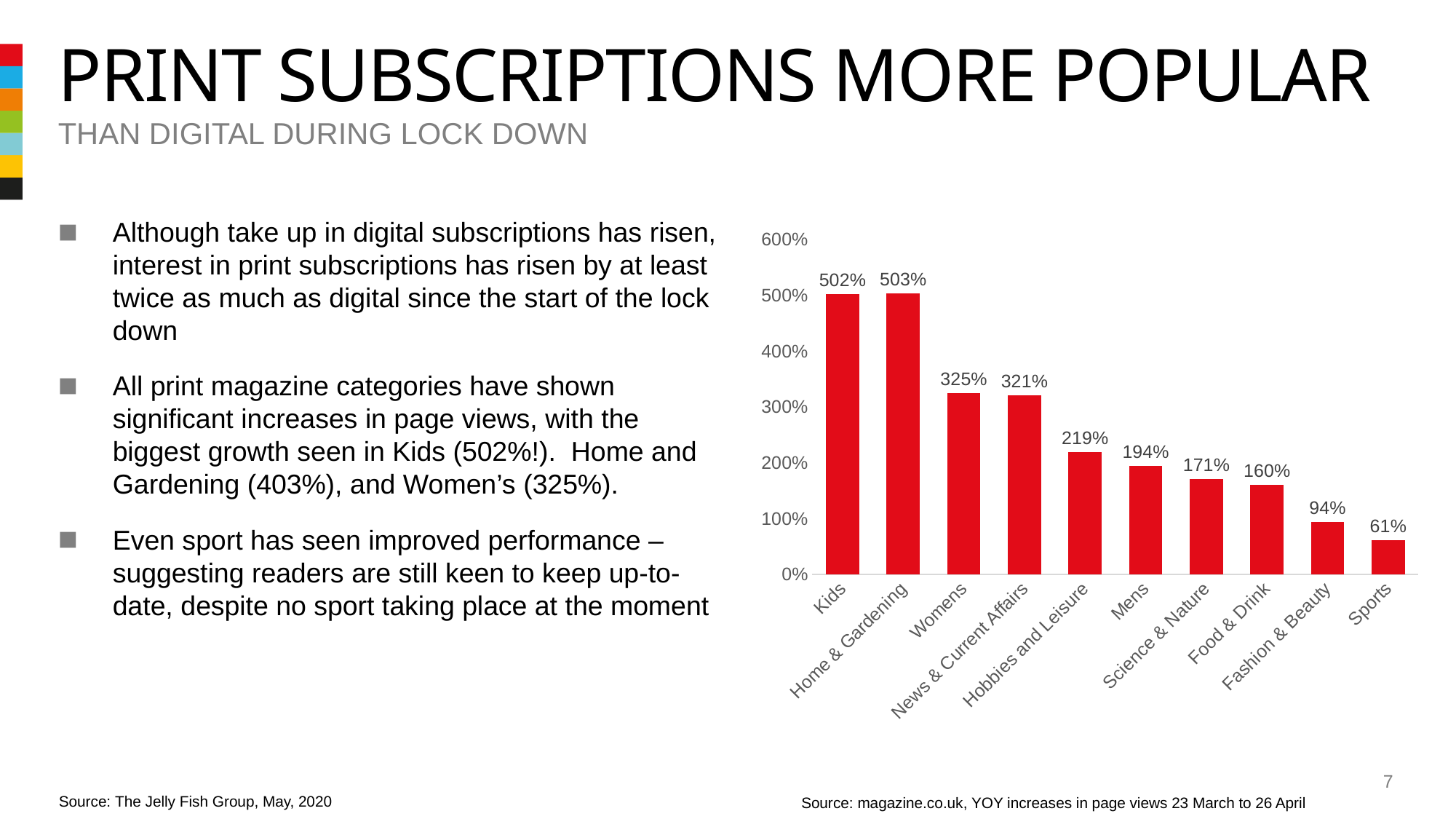
Which category has the lowest value in the chart? Sports What is the difference between the values for Science & Nature and Sports? 110% Which is larger, the value for Hobbies and Leisure or the value for Science & Nature? Hobbies and Leisure How many categories are shown in the chart? 10 What kind of chart is shown on the slide? Bar chart What is the value for Fashion & Beauty in the chart? 94% What is the value for Kids in the chart? 502% What is the value for Food & Drink in the chart? 160% Is the value for Mens greater or less than 200%? less What is the difference between the values for Womens and Mens? 131% What is the value for Hobbies and Leisure in the chart? 219% Do the values generally rise or fall from left to right across the categories? Fall